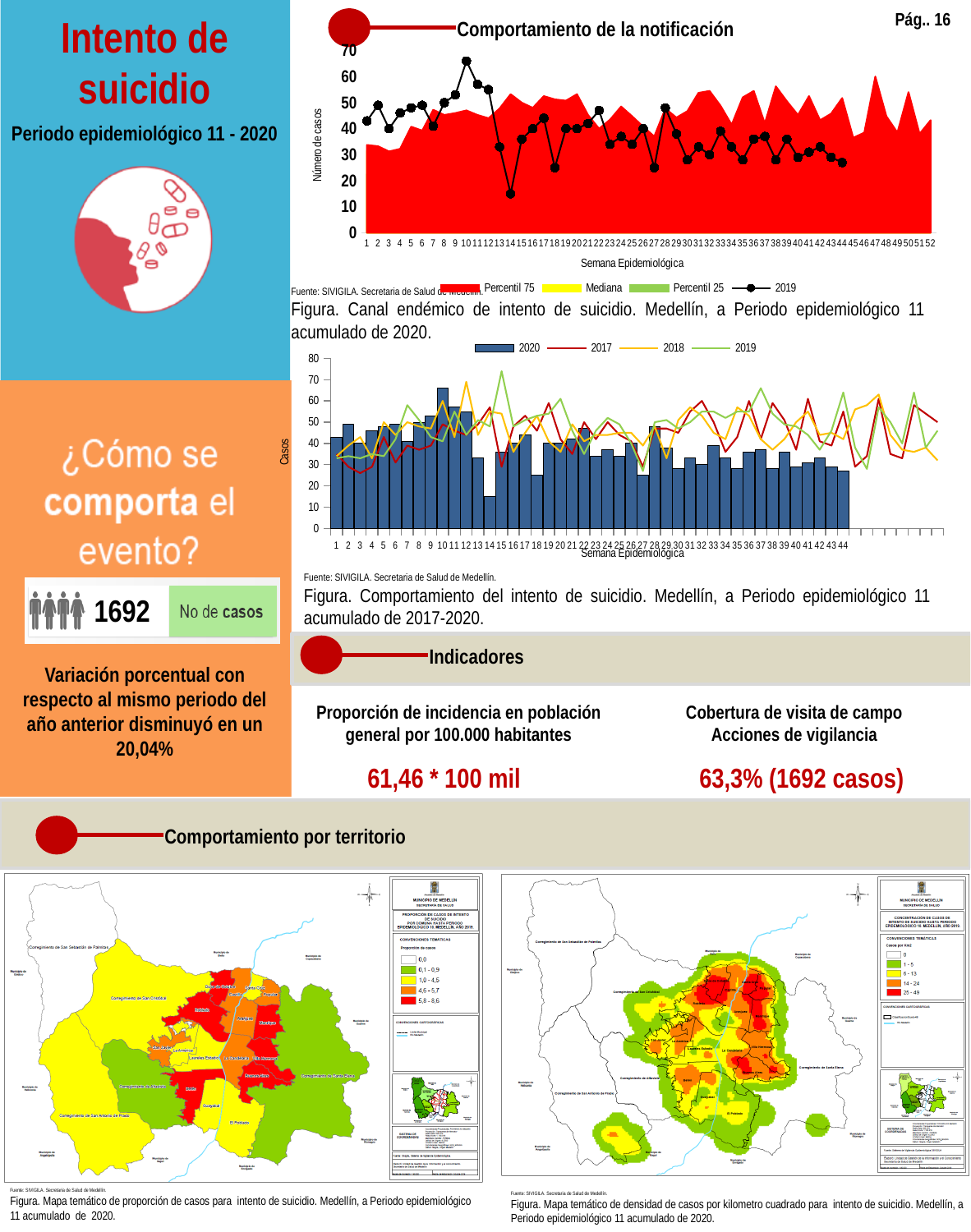
In the 'Comportamiento del intento de suicidio' chart (second chart), at which epidemiological week is the 2020 bar highest? 10 In the 'Comportamiento del intento de suicidio' chart (second chart), is the 2020 bar at week 14 greater or less than 20? less In the 'Comportamiento del intento de suicidio' chart (second chart), which year is plotted as bars? 2020 In the 'Canal endémico' chart at the top, how many series does the legend list? 4 In the 'Canal endémico' chart at the top, is the value of the black line at week 14 greater or less than 20? less In the 'Comportamiento del intento de suicidio' chart (second chart), how many series does the legend list? 4 In the 'Comportamiento del intento de suicidio' chart (second chart), which is larger, the 2020 bar at week 10 or the 2020 bar at week 44? week 10 In the 'Comportamiento del intento de suicidio' chart (second chart), how many weeks have a 2020 bar plotted? 44 In the 'Canal endémico' chart at the top, which legend entry is shown in red? Percentil 75 In the 'Canal endémico' chart at the top, what is the label of the y axis? Número de casos In the 'Comportamiento del intento de suicidio' chart (second chart), at which epidemiological week is the 2020 bar lowest? 14 In the 'Canal endémico' chart at the top, is the value of the black line at week 10 greater or less than 60? greater